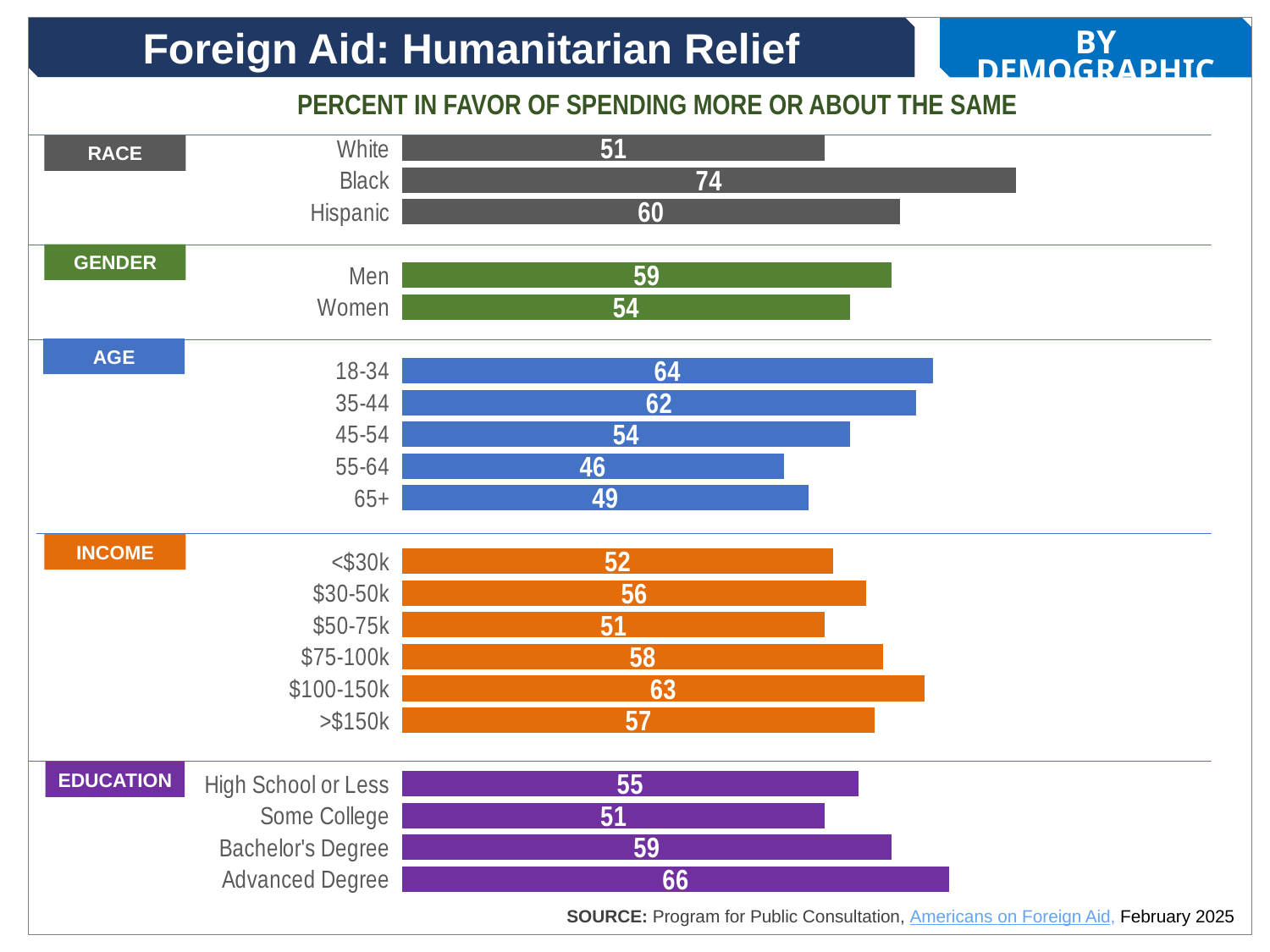
What colour are the bars for the Education categories? Purple What is the difference between the values for Men and Women? 5 Which race category has the highest value? Black Which is larger, the value for 18-34 or the value for 65+? 18-34 How many income categories are shown? 6 What percent of Black respondents favor spending more or about the same on humanitarian relief? 74 What kind of chart is shown on the slide? Bar chart What is the value shown for the 55-64 age group? 46 Which age group has the lowest value? 55-64 Which income group has the highest value? $100-150k What is the value shown for respondents with an Advanced Degree? 66 What is the difference between the values for Black and White respondents? 23